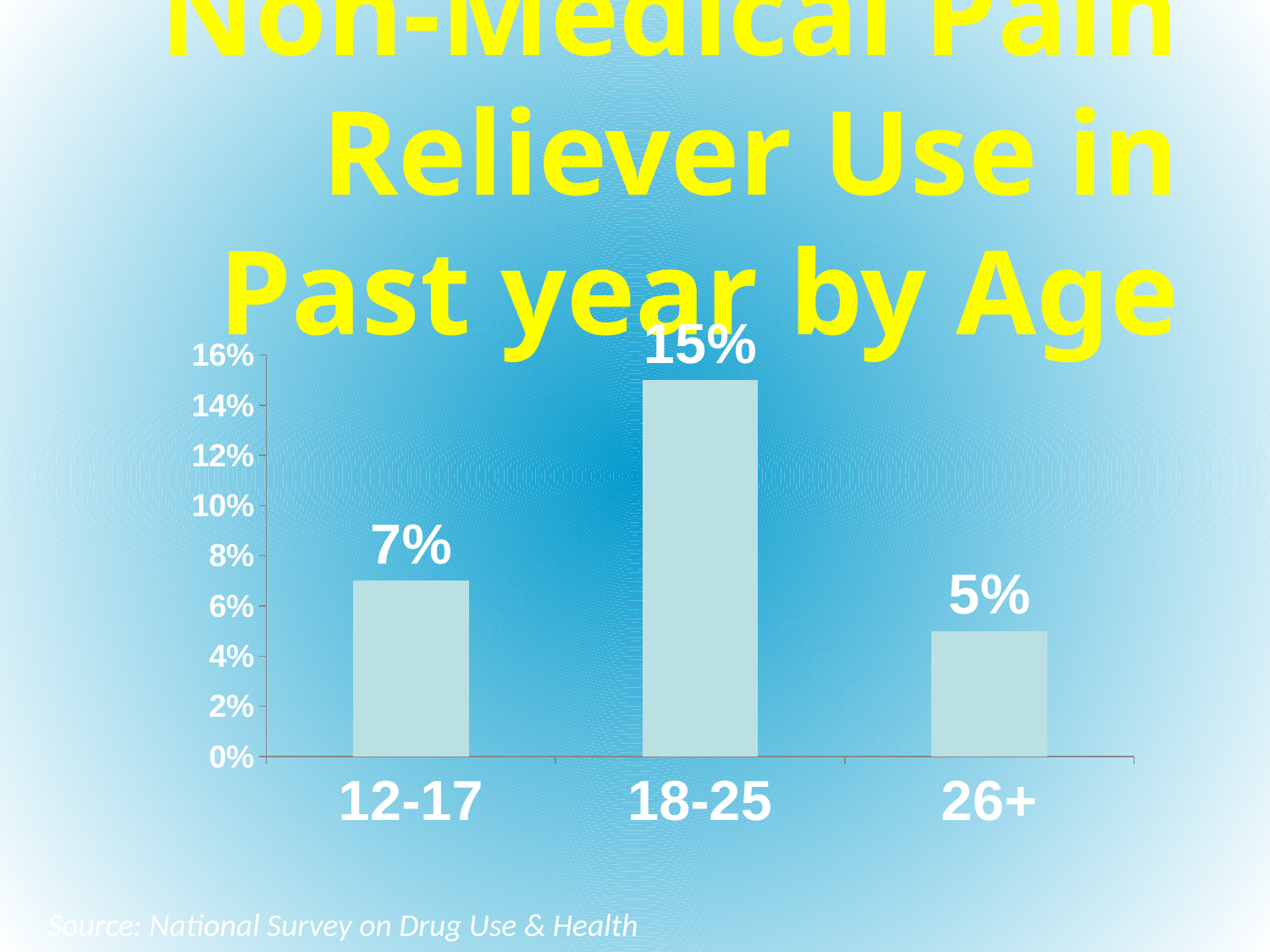
What is the value for the 18-25 age group? 15% How many age groups are shown on the chart? 3 Which age group has the lowest value? 26+ What is the value for the 26+ age group? 5% Which age group has the highest value? 18-25 What is the difference between the values for 18-25 and 12-17? 8% What is the value for the 12-17 age group? 7% What is the difference between the values for 12-17 and 26+? 2% What kind of chart is shown on the slide? bar chart What source is cited for the chart data? National Survey on Drug Use & Health Which is larger, the value for 12-17 or the value for 26+? 12-17 Is the value for 18-25 greater or less than 10%? greater